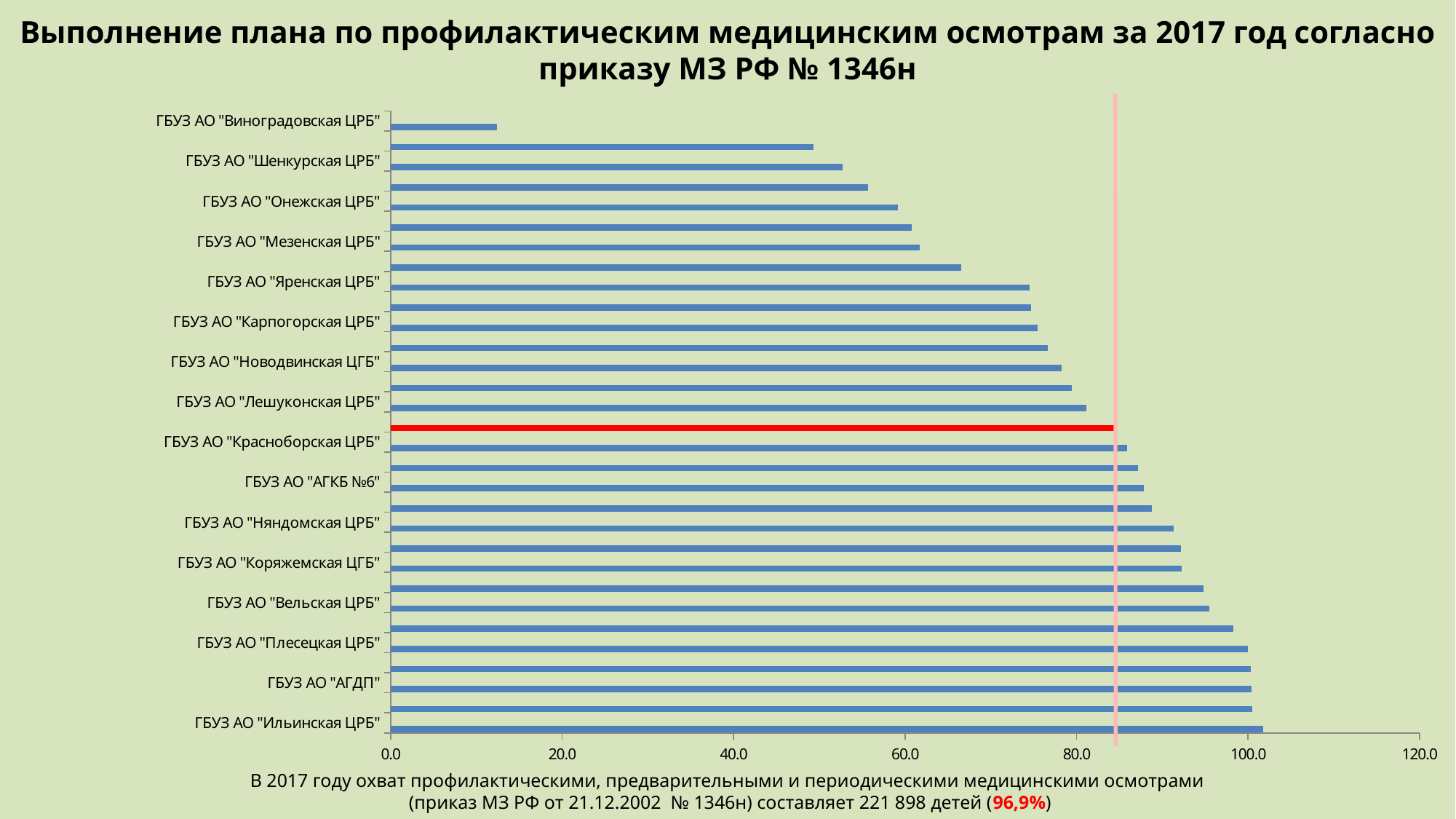
Do the bar values increase or decrease going from the top of the chart to the bottom? Increase Is the value for ГБУЗ АО "Карпогорская ЦРБ" greater or less than 80? less Which has the larger value, ГБУЗ АО "Яренская ЦРБ" or ГБУЗ АО "Няндомская ЦРБ"? ГБУЗ АО "Няндомская ЦРБ" Which has the larger value, ГБУЗ АО "Виноградовская ЦРБ" or ГБУЗ АО "Шенкурская ЦРБ"? ГБУЗ АО "Шенкурская ЦРБ" What kind of chart is shown on the slide? Bar chart Is the value for ГБУЗ АО "Виноградовская ЦРБ" greater or less than 20? less Which labelled institution has the lowest value on the chart? ГБУЗ АО "Виноградовская ЦРБ" Is the value for ГБУЗ АО "Коряжемская ЦГБ" greater or less than 100? less What is the highest value shown on the horizontal axis of the chart? 120.0